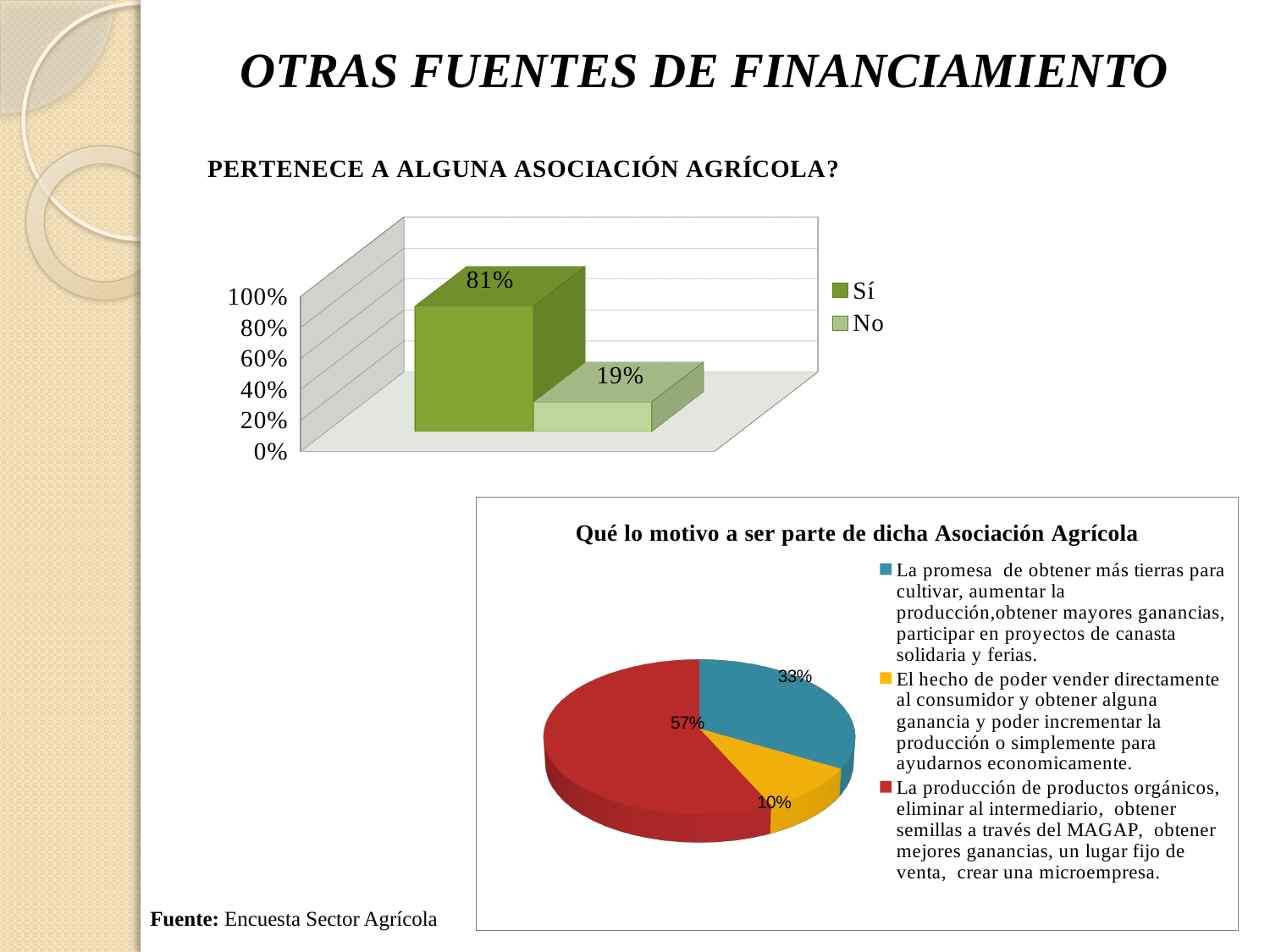
What kind of chart is the chart titled 'PERTENECE A ALGUNA ASOCIACIÓN AGRÍCOLA?'? Bar chart In the bar chart 'PERTENECE A ALGUNA ASOCIACIÓN AGRÍCOLA?', what is the value for 'Sí'? 81% In the pie chart 'Qué lo motivo a ser parte de dicha Asociación Agrícola', what share does the slice 'La promesa de obtener más tierras para cultivar...' have? 33% In the bar chart 'PERTENECE A ALGUNA ASOCIACIÓN AGRÍCOLA?', what is the difference between the values for 'Sí' and 'No'? 62% In the pie chart 'Qué lo motivo a ser parte de dicha Asociación Agrícola', which slice is the smallest? El hecho de poder vender directamente al consumidor y obtener alguna ganancia y poder incrementar la producción o simplemente para ayudarnos economicamente. In the pie chart 'Qué lo motivo a ser parte de dicha Asociación Agrícola', how many slices are there? 3 In the bar chart 'PERTENECE A ALGUNA ASOCIACIÓN AGRÍCOLA?', which category has the highest value? Sí In the pie chart 'Qué lo motivo a ser parte de dicha Asociación Agrícola', what share does the slice 'El hecho de poder vender directamente al consumidor...' have? 10% In the bar chart 'PERTENECE A ALGUNA ASOCIACIÓN AGRÍCOLA?', how many entries does the legend list? 2 In the pie chart 'Qué lo motivo a ser parte de dicha Asociación Agrícola', what share does the slice 'La producción de productos orgánicos, eliminar al intermediario...' have? 57% What kind of chart is the chart titled 'Qué lo motivo a ser parte de dicha Asociación Agrícola'? Pie chart In the bar chart 'PERTENECE A ALGUNA ASOCIACIÓN AGRÍCOLA?', what is the value for 'No'? 19%